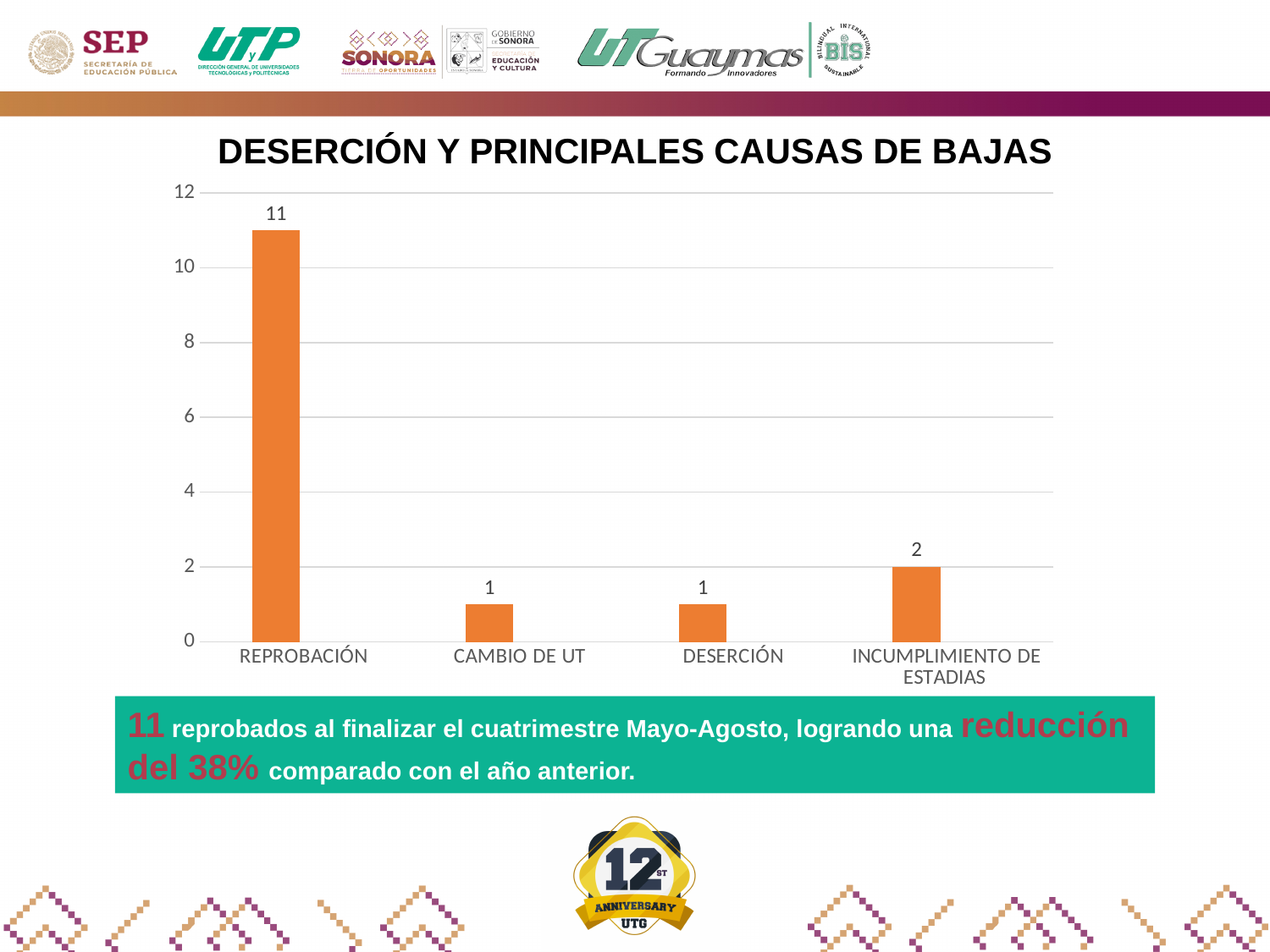
What is the total of all four bar values? 15 What kind of chart is shown on the slide? bar chart Which category has the highest value? REPROBACIÓN What is the value for INCUMPLIMIENTO DE ESTADIAS? 2 What is the highest value shown on the y axis? 12 What is the difference between the values for REPROBACIÓN and INCUMPLIMIENTO DE ESTADIAS? 9 Which is larger, the value for INCUMPLIMIENTO DE ESTADIAS or the value for DESERCIÓN? INCUMPLIMIENTO DE ESTADIAS What is the value for CAMBIO DE UT? 1 How many categories are shown on the x axis? 4 What is the value for REPROBACIÓN? 11 Is the value for REPROBACIÓN greater or less than 10? greater What is the title of the chart? DESERCIÓN Y PRINCIPALES CAUSAS DE BAJAS